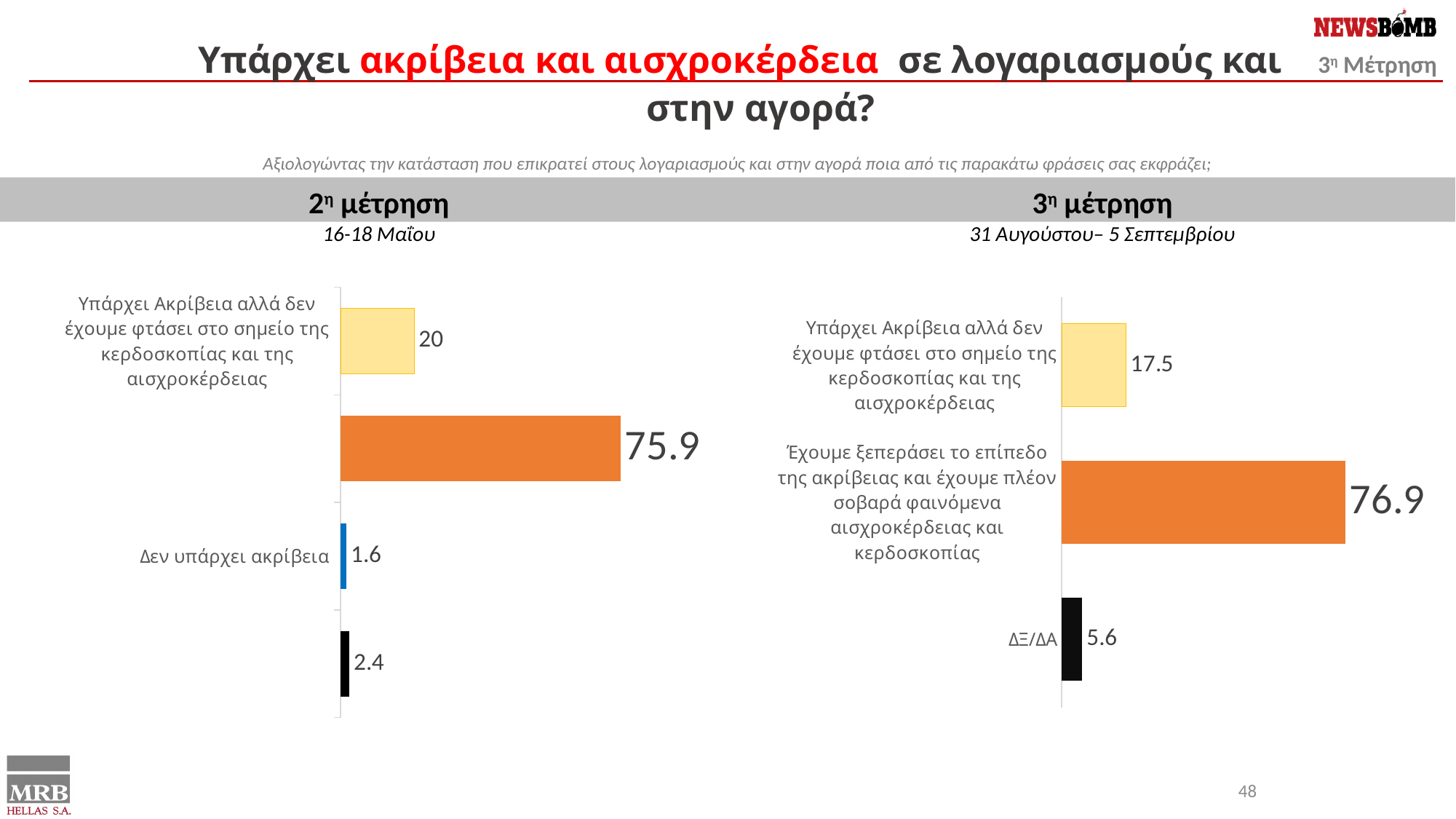
In the 3η μέτρηση chart, what is the value for 'Έχουμε ξεπεράσει το επίπεδο της ακρίβειας και έχουμε πλέον σοβαρά φαινόμενα αισχροκέρδειας και κερδοσκοπίας'? 76.9 Which is larger: the value for 'Υπάρχει Ακρίβεια αλλά δεν έχουμε φτάσει...' in the 2η μέτρηση chart or in the 3η μέτρηση chart? 2η μέτρηση In the 2η μέτρηση chart, what is the value for 'Υπάρχει Ακρίβεια αλλά δεν έχουμε φτάσει στο σημείο της κερδοσκοπίας και της αισχροκέρδειας'? 20 How many bars are shown in the 2η μέτρηση chart? 4 In the 3η μέτρηση chart, what is the value for 'ΔΞ/ΔΑ'? 5.6 In the 3η μέτρηση chart, what is the difference between the value for 'Έχουμε ξεπεράσει το επίπεδο της ακρίβειας...' and the value for 'Υπάρχει Ακρίβεια αλλά δεν έχουμε φτάσει...'? 59.4 How many bars are shown in the 3η μέτρηση chart? 3 What type of chart is the 3η μέτρηση chart? Bar chart In the 2η μέτρηση chart, what is the highest value shown? 75.9 In the 3η μέτρηση chart, which category has the lowest value? ΔΞ/ΔΑ In the 3η μέτρηση chart, what is the value for 'Υπάρχει Ακρίβεια αλλά δεν έχουμε φτάσει στο σημείο της κερδοσκοπίας και της αισχροκέρδειας'? 17.5 In the 2η μέτρηση chart, what is the value for 'Δεν υπάρχει ακρίβεια'? 1.6